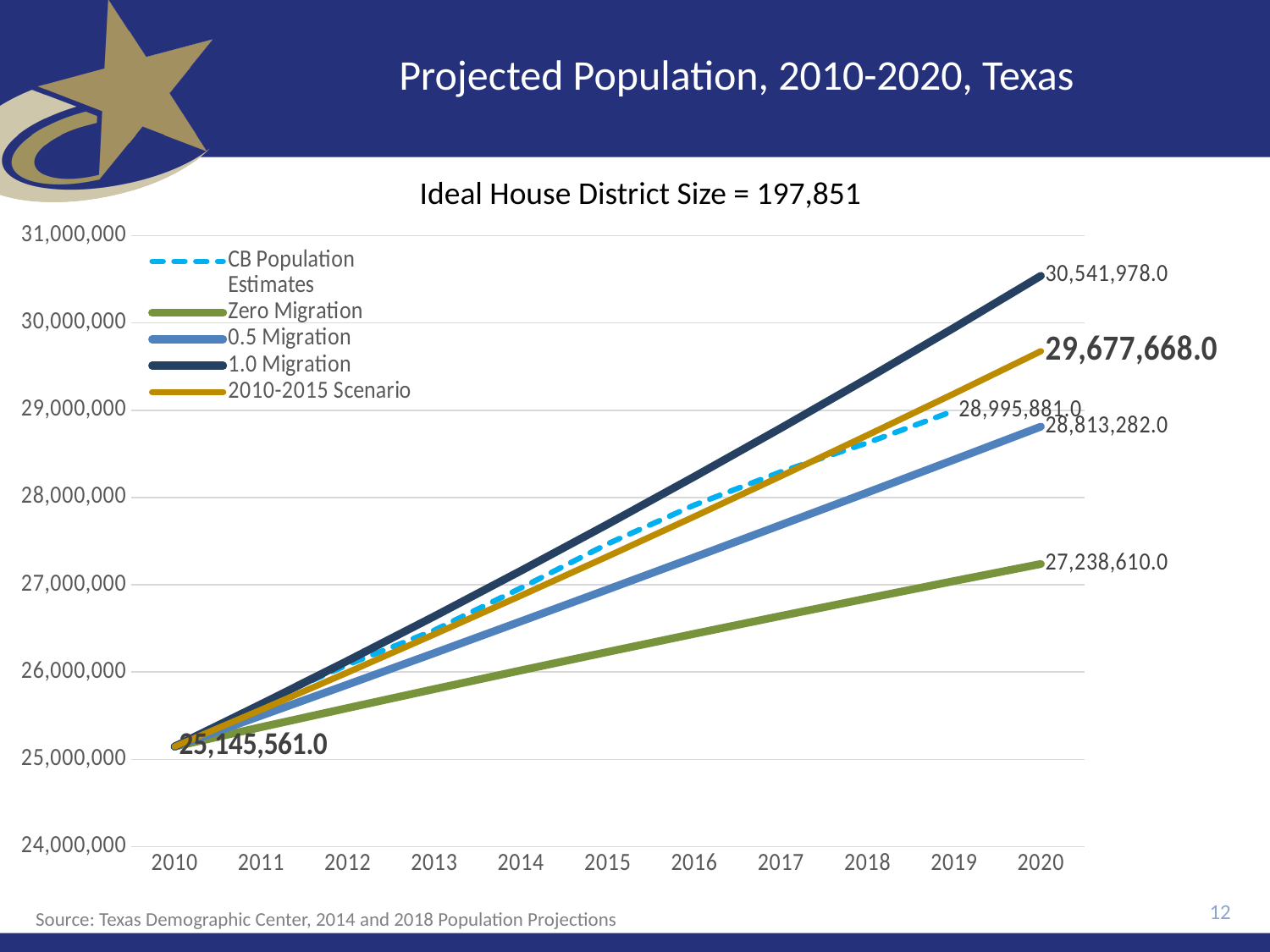
What is the value of the 1.0 Migration series in 2020? 30,541,978.0 Which series has the lowest value in 2020? Zero Migration Is the value of the 1.0 Migration series in 2015 greater or less than 27,000,000? greater What is the value of the 2010-2015 Scenario series in 2020? 29,677,668.0 What is the difference between the 1.0 Migration and Zero Migration values in 2020? 3,303,368.0 What is the starting population value shown for 2010? 25,145,561.0 Which series is drawn with a dashed line? CB Population Estimates What type of chart is shown on the slide? Line chart What is the value of the 0.5 Migration series in 2020? 28,813,282.0 How many series does the legend list? 5 What is the value of the Zero Migration series in 2020? 27,238,610.0 Which series has the highest value in 2020? 1.0 Migration